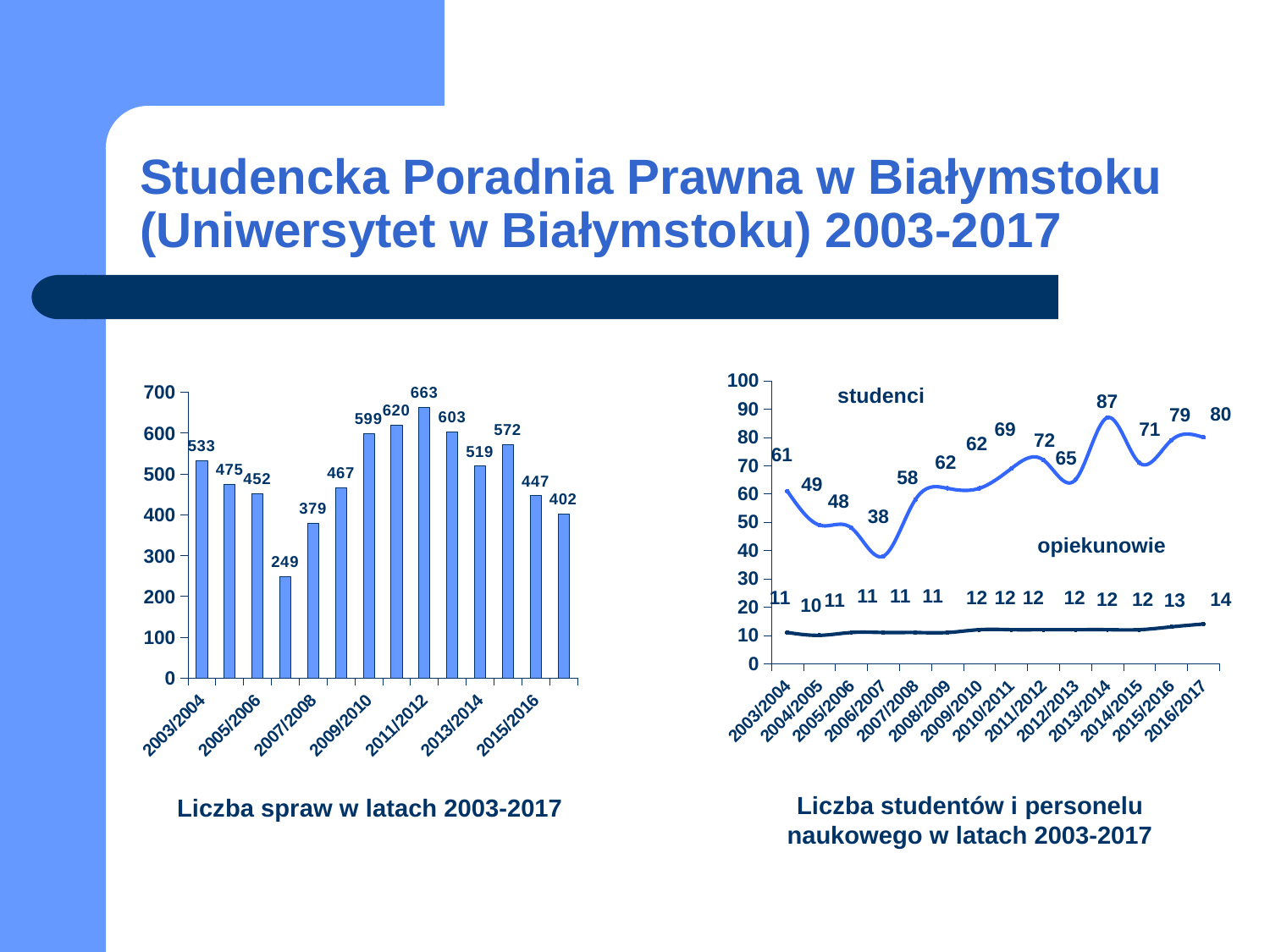
In the left chart 'Liczba spraw w latach 2003-2017', what is the value for 2003/2004? 533 What kind of chart is the left chart, 'Liczba spraw w latach 2003-2017'? bar chart In the right chart, what is the value for studenci in 2013/2014? 87 How many bars are in the left chart 'Liczba spraw w latach 2003-2017'? 14 In the left chart 'Liczba spraw w latach 2003-2017', which is larger, the value for 2009/2010 or for 2013/2014? 2009/2010 In the right chart, what is the value for opiekunowie in 2016/2017? 14 In the right chart, in which year is the value for studenci lowest? 2006/2007 What kind of chart is the right chart, 'Liczba studentów i personelu naukowego w latach 2003-2017'? line chart In the right chart, what is the difference between studenci and opiekunowie in 2016/2017? 66 In the left chart 'Liczba spraw w latach 2003-2017', what is the difference between the values for 2011/2012 and 2015/2016? 216 In the left chart 'Liczba spraw w latach 2003-2017', what is the lowest value shown? 249 In the left chart 'Liczba spraw w latach 2003-2017', what is the value for 2011/2012? 663